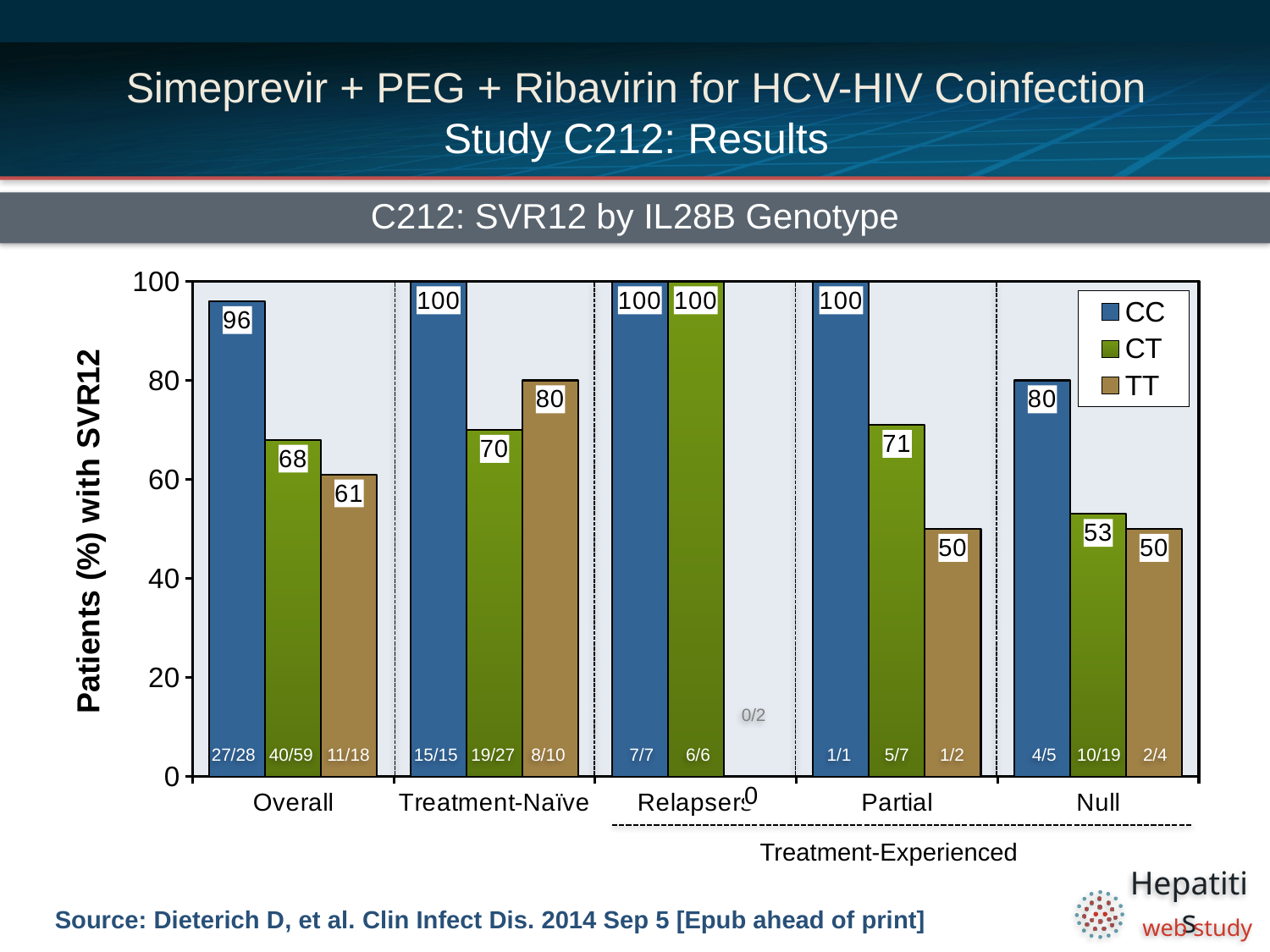
Is the SVR12 rate for CT in the Null group higher or lower than for TT in the Null group? higher What is the title of the chart? C212: SVR12 by IL28B Genotype What is the SVR12 rate for the CC genotype in the Overall group? 96 Which genotype has the highest SVR12 rate in the Null group? CC What kind of chart is shown on the slide? Bar chart What is the SVR12 rate for the TT genotype in the Treatment-Naïve group? 80 What is the SVR12 rate for the TT genotype in the Relapsers group? 0 How many patient groups are shown along the x axis? 5 What is the SVR12 rate for the CT genotype in the Partial group? 71 How many series does the legend list? 3 What is the difference between the CC and CT SVR12 rates in the Overall group? 28 Which genotype has the lowest SVR12 rate in the Overall group? TT